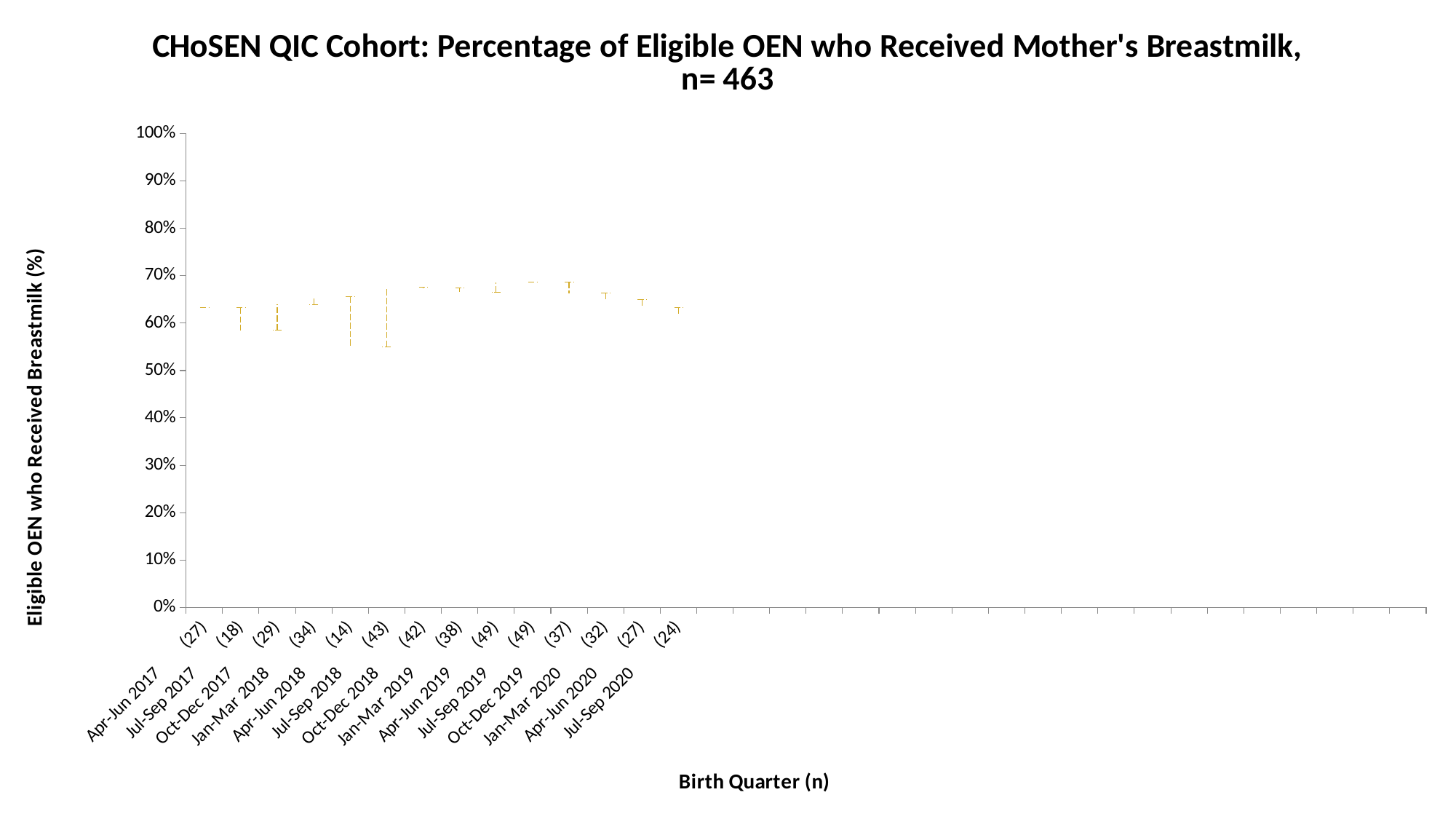
How many birth quarters are plotted on the x axis? 14 Which birth quarter has the smallest n shown in parentheses? Apr-Jun 2018 What is the n shown in parentheses for the Jul-Sep 2019 birth quarter? (49) Is the value for Apr-Jun 2017 greater or less than 50%? greater What is the first birth quarter shown on the x axis? Apr-Jun 2017 What is the n shown in parentheses for the Jul-Sep 2018 birth quarter? (43) What is the label of the x axis? Birth Quarter (n) What is the n shown in parentheses for the Jul-Sep 2020 birth quarter? (24) What is the title of the chart? CHoSEN QIC Cohort: Percentage of Eligible OEN who Received Mother's Breastmilk, n= 463 What is the total n stated in the chart title? 463 Is the value for Jul-Sep 2020 greater or less than 70%? less